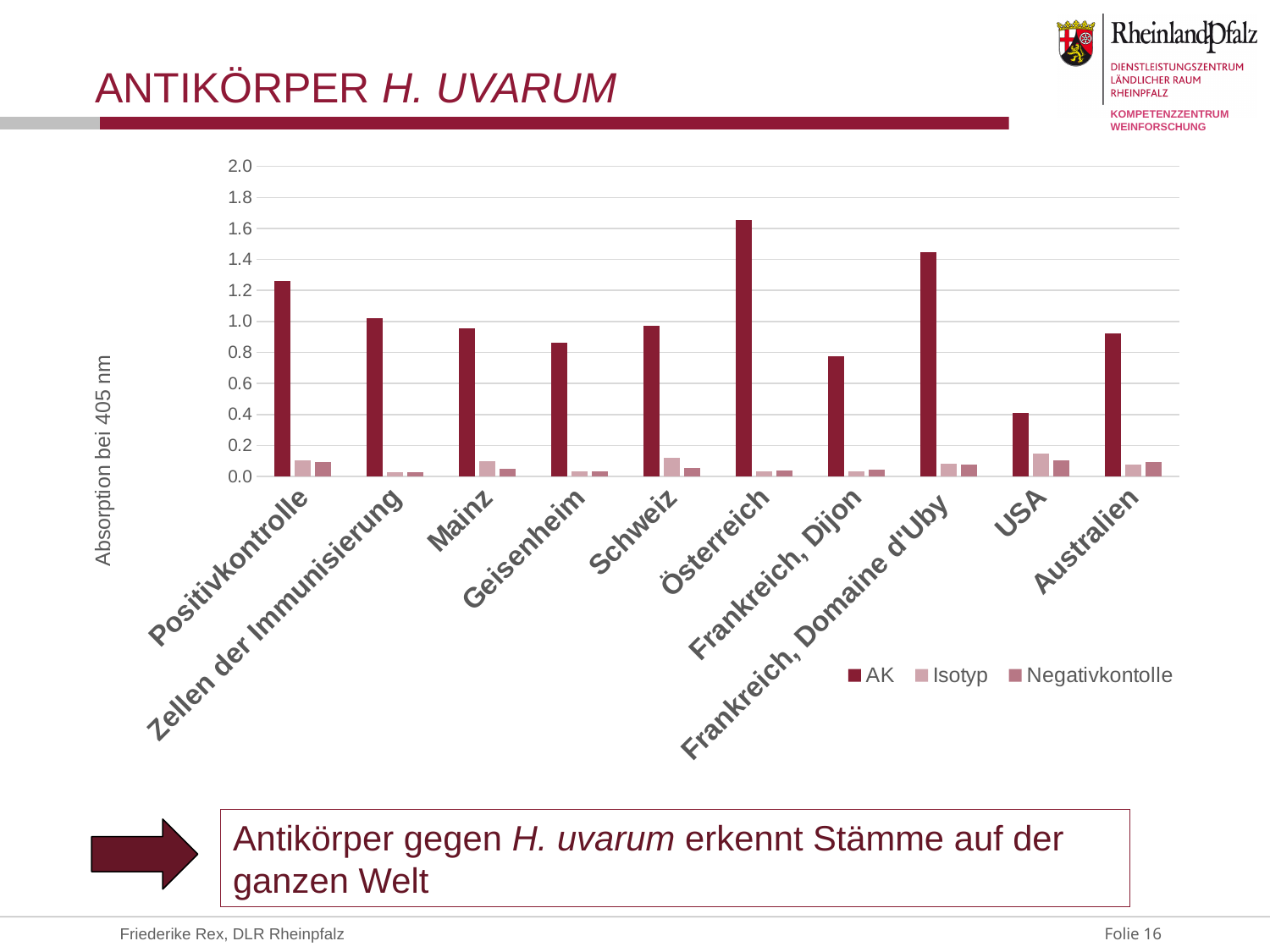
Is the AK value for USA greater or less than 0.6? less How many series does the chart's legend list? 3 How many categories are shown along the x axis of the chart? 10 Is the AK value for Frankreich, Domaine d'Uby greater or less than 1.2? greater What kind of chart is shown on the slide? bar chart Is the AK value for Geisenheim greater or less than 1.0? less Which category has the highest AK value? Österreich Which has the larger AK value, Österreich or Frankreich, Domaine d'Uby? Österreich Which has the larger AK value, Zellen der Immunisierung or Geisenheim? Zellen der Immunisierung What is the title of the chart's vertical axis? Absorption bei 405 nm Which category has the lowest AK value? USA